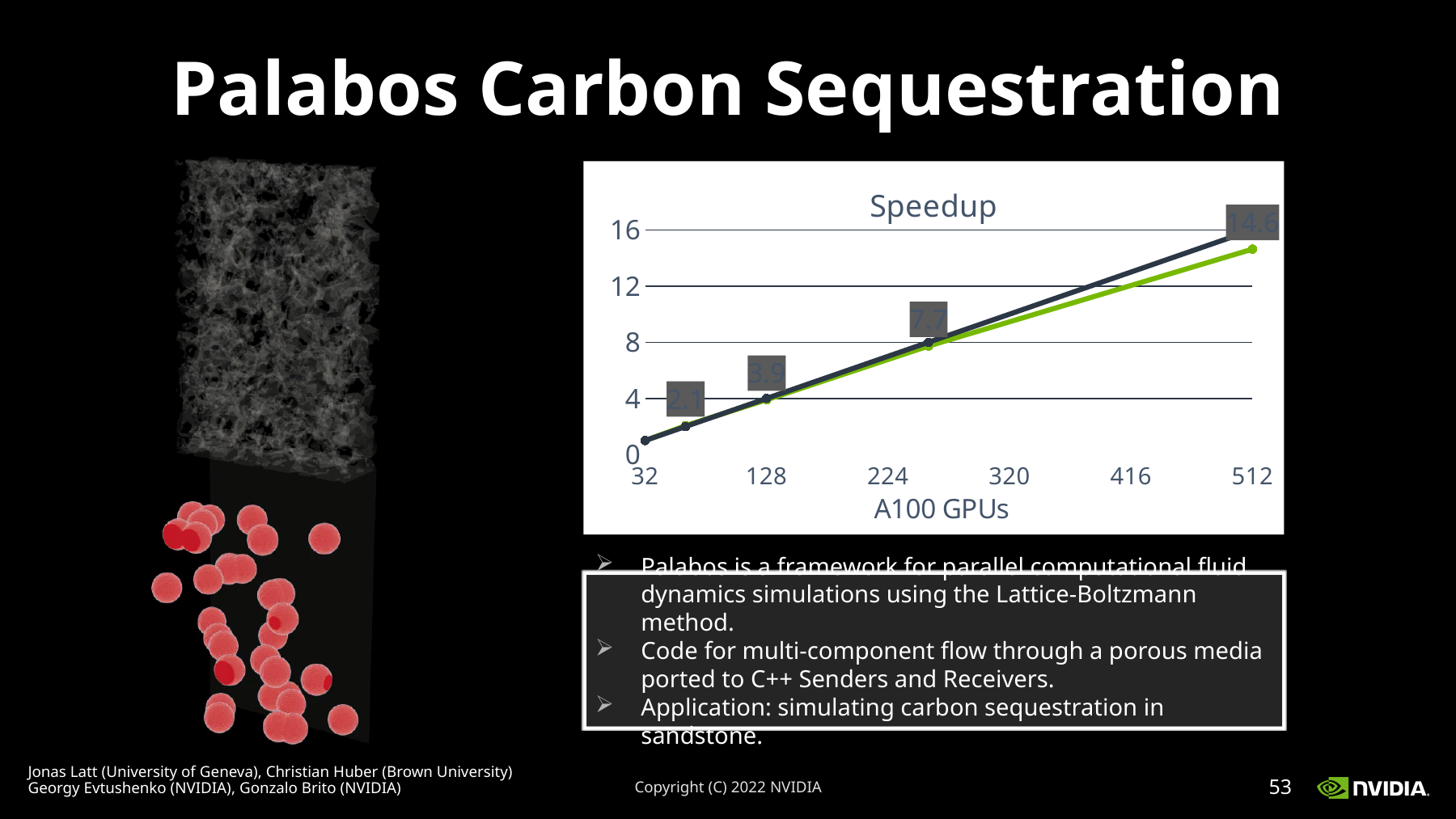
How many data labels are printed on the Speedup chart? 4 What is the label of the x axis of the Speedup chart? A100 GPUs What is the highest data label shown in the Speedup chart? 14.6 In the Speedup chart, what is the difference between the labeled speedup at 512 GPUs and at 128 GPUs? 10.7 In the Speedup chart, what is the difference between the data labels 7.7 and 3.9? 3.8 What kind of chart is shown on the slide? line chart In the Speedup chart, what is the labeled speedup at 512 A100 GPUs? 14.6 What is the title of the chart on the slide? Speedup In the Speedup chart, is the labeled speedup at 512 GPUs greater or less than 12? greater What is the lowest data label shown in the Speedup chart? 2.1 In the Speedup chart, what is the labeled speedup at 128 A100 GPUs? 3.9 Does the speedup rise or fall as the number of A100 GPUs increases? rises